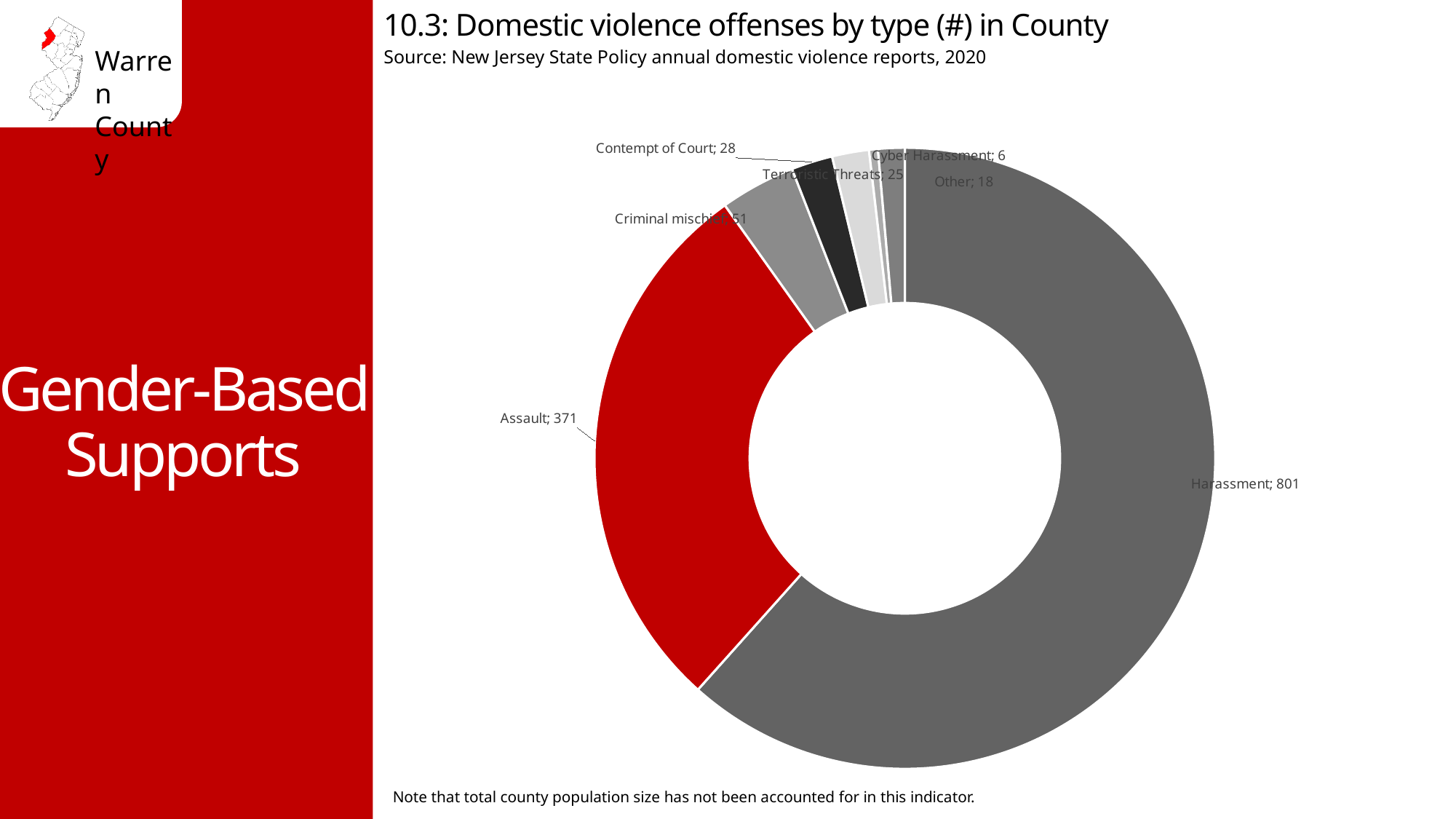
What is the number of Harassment offenses shown in the chart? 801 What type of chart is shown on the slide? Doughnut chart Which offense type has the highest value? Harassment Which is larger, Contempt of Court or Terroristic Threats? Contempt of Court What is the total of all offense values shown in the chart? 1300 What is the value for Criminal mischief? 51 What is the source cited for the chart? New Jersey State Policy annual domestic violence reports, 2020 What is the difference between the Harassment and Assault values? 430 What is the value for Cyber Harassment? 6 How many offense types are shown in the chart? 7 Which offense type has the lowest value? Cyber Harassment What is the number of Assault offenses shown in the chart? 371